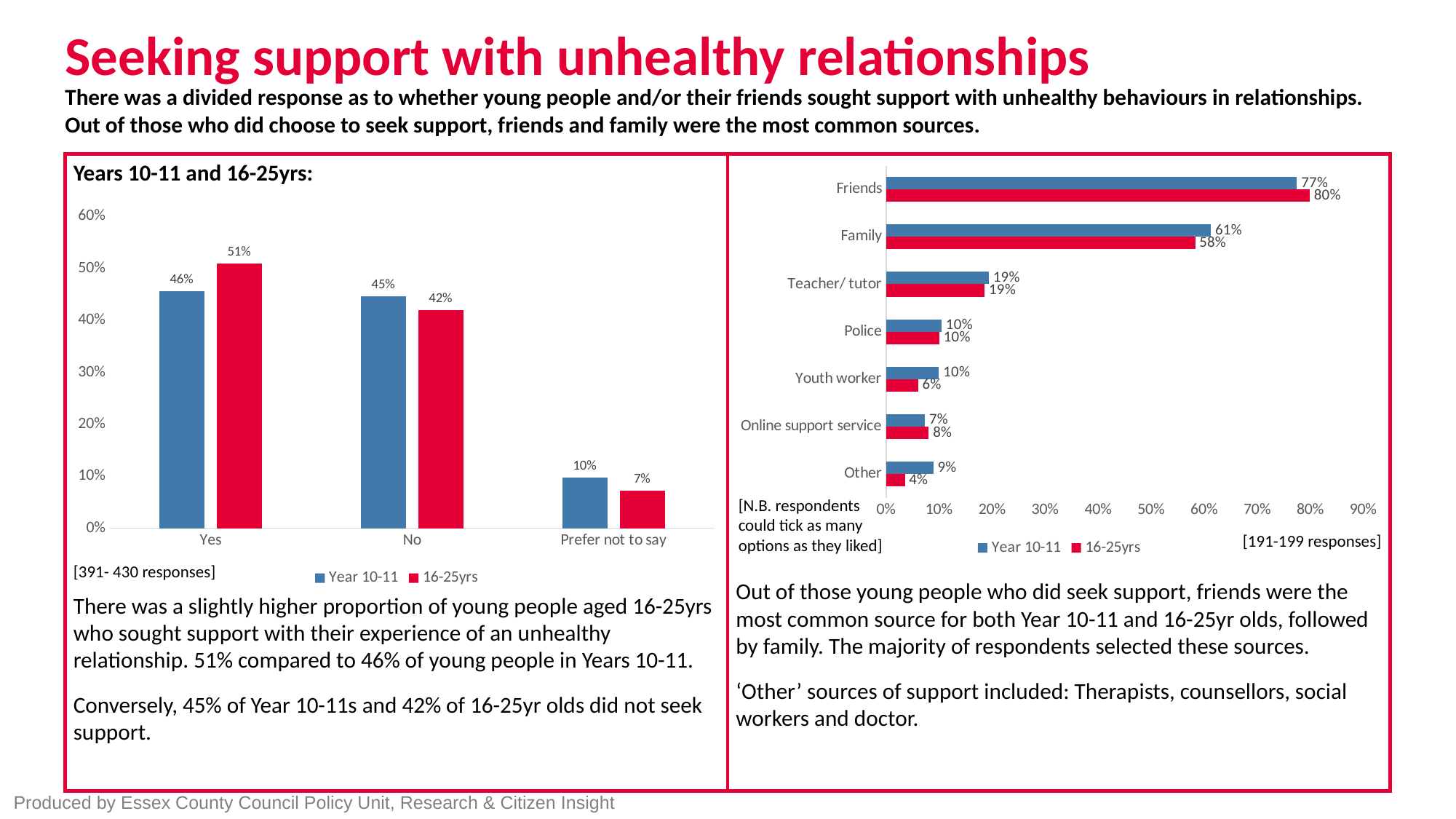
In the left chart (Years 10-11 and 16-25yrs), what is the value for 16-25yrs in the 'Yes' category? 51% In the right chart, which source has the highest value for Year 10-11? Friends In the left chart (Years 10-11 and 16-25yrs), what is the value for Year 10-11 in the 'Prefer not to say' category? 10% In the left chart (Years 10-11 and 16-25yrs), which series has the larger value for 'Yes'? 16-25yrs In the right chart, what is the value for Year 10-11 for 'Youth worker'? 10% In the left chart (Years 10-11 and 16-25yrs), how many categories are shown on the x axis? 3 In the left chart (Years 10-11 and 16-25yrs), what is the difference between Year 10-11 and 16-25yrs in the 'No' category? 3% In the right chart, what is the value for 16-25yrs for 'Friends'? 80% In the right chart, which source has the lowest value for 16-25yrs? Other In the right chart, how many sources of support are listed? 7 In the right chart, what is the difference between Year 10-11 and 16-25yrs for 'Other'? 5% What type of chart is the right chart? Bar chart